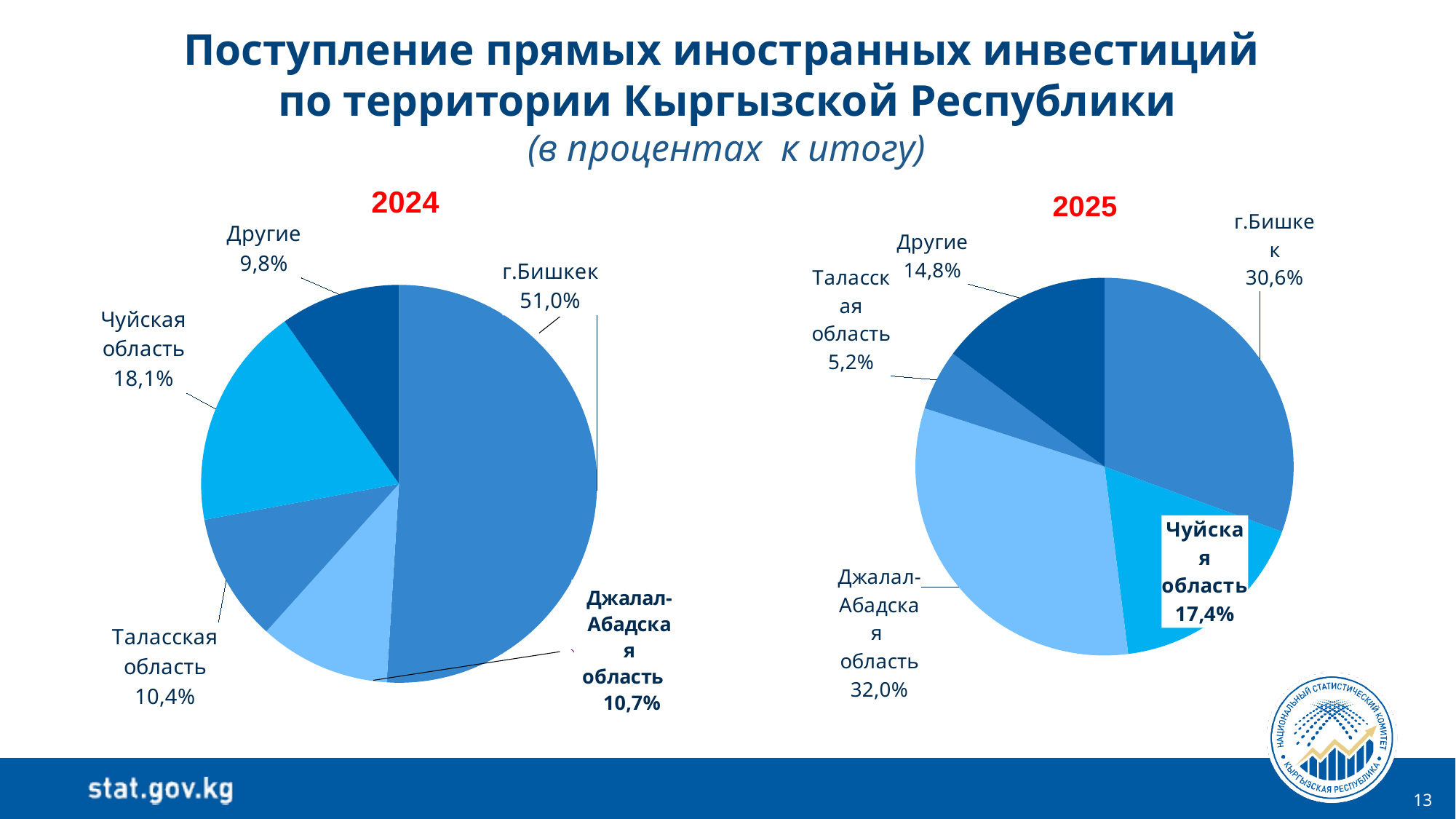
In the 2024 pie chart, what is the difference between the shares of Чуйская область and Другие? 8,3% In the 2024 pie chart, which category has the smallest share? Другие In the 2025 pie chart, which is larger: the share of Чуйская область or the share of Другие? Чуйская область What type of chart is used for the 2025 data? Pie chart What are the two years shown in the chart titles on the slide? 2024 and 2025 In the 2024 pie chart, what share does г.Бишкек have? 51,0% In the 2025 pie chart, what share does Таласская область have? 5,2% In the 2024 pie chart, which category has the largest share? г.Бишкек In the 2025 pie chart, what is the difference between the shares of Джалал-Абадская область and г.Бишкек? 1,4% In the 2025 pie chart, what share does Джалал-Абадская область have? 32,0% How many slices does the 2024 pie chart have? 5 In the 2025 pie chart, which category has the smallest share? Таласская область